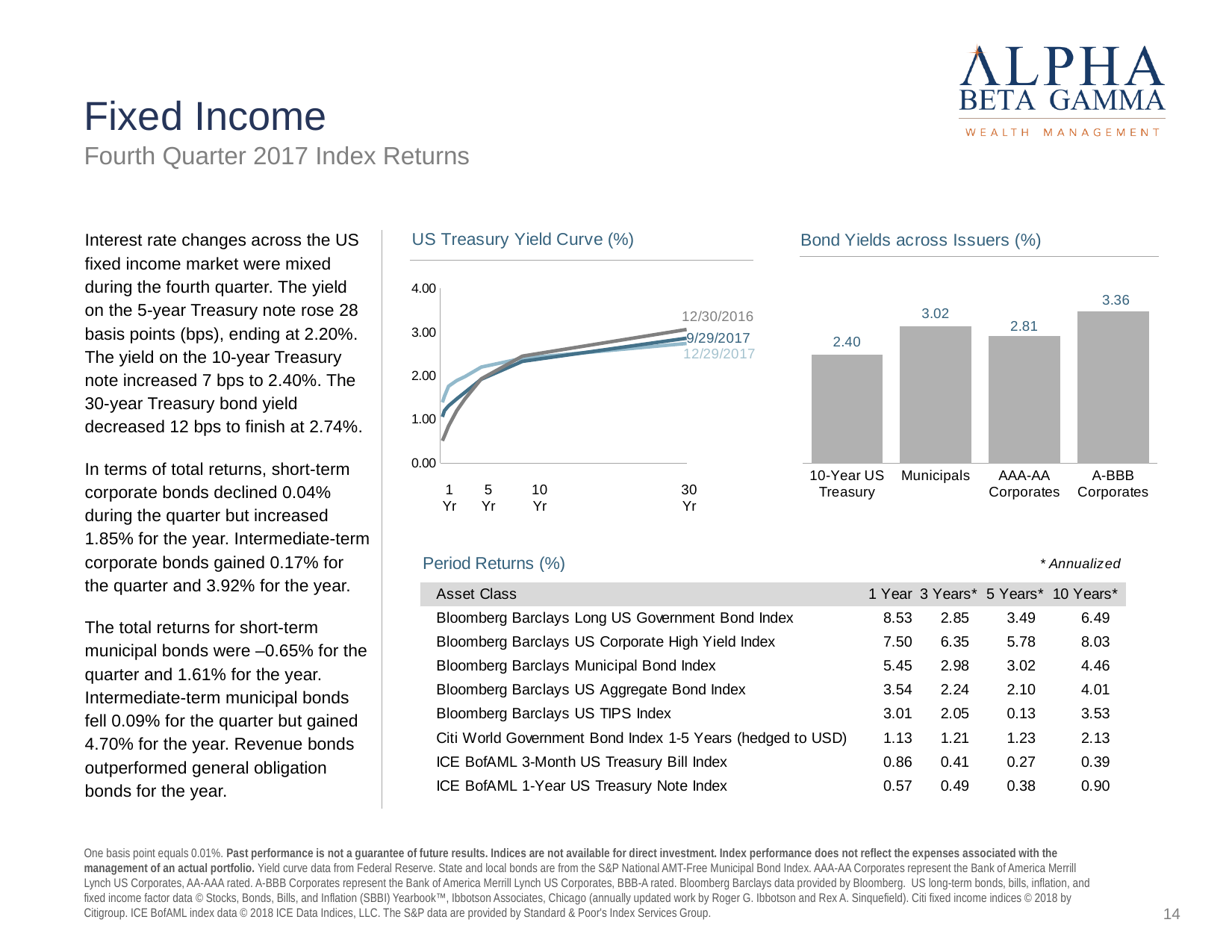
In the Bond Yields across Issuers (%) chart, which is larger: the yield for Municipals or the yield for AAA-AA Corporates? Municipals In the Bond Yields across Issuers (%) chart, which issuer category has the lowest yield? 10-Year US Treasury In the Bond Yields across Issuers (%) chart, which issuer category has the highest yield? A-BBB Corporates In the Bond Yields across Issuers (%) chart, what is the yield for Municipals? 3.02 What kind of chart is the US Treasury Yield Curve (%) chart? Line chart What kind of chart is the Bond Yields across Issuers (%) chart? Bar chart In the US Treasury Yield Curve (%) chart, do the yields generally rise or fall as maturity increases from 1 Yr to 30 Yr? Rise In the US Treasury Yield Curve (%) chart, is the 12/29/2017 value at 1 Yr greater or less than 1.00? greater How many series (dates) are plotted in the US Treasury Yield Curve (%) chart? 3 In the Bond Yields across Issuers (%) chart, what is the yield for the 10-Year US Treasury? 2.40 In the Bond Yields across Issuers (%) chart, what is the difference between the A-BBB Corporates yield and the AAA-AA Corporates yield? 0.55 How many issuer categories are shown in the Bond Yields across Issuers (%) chart? 4